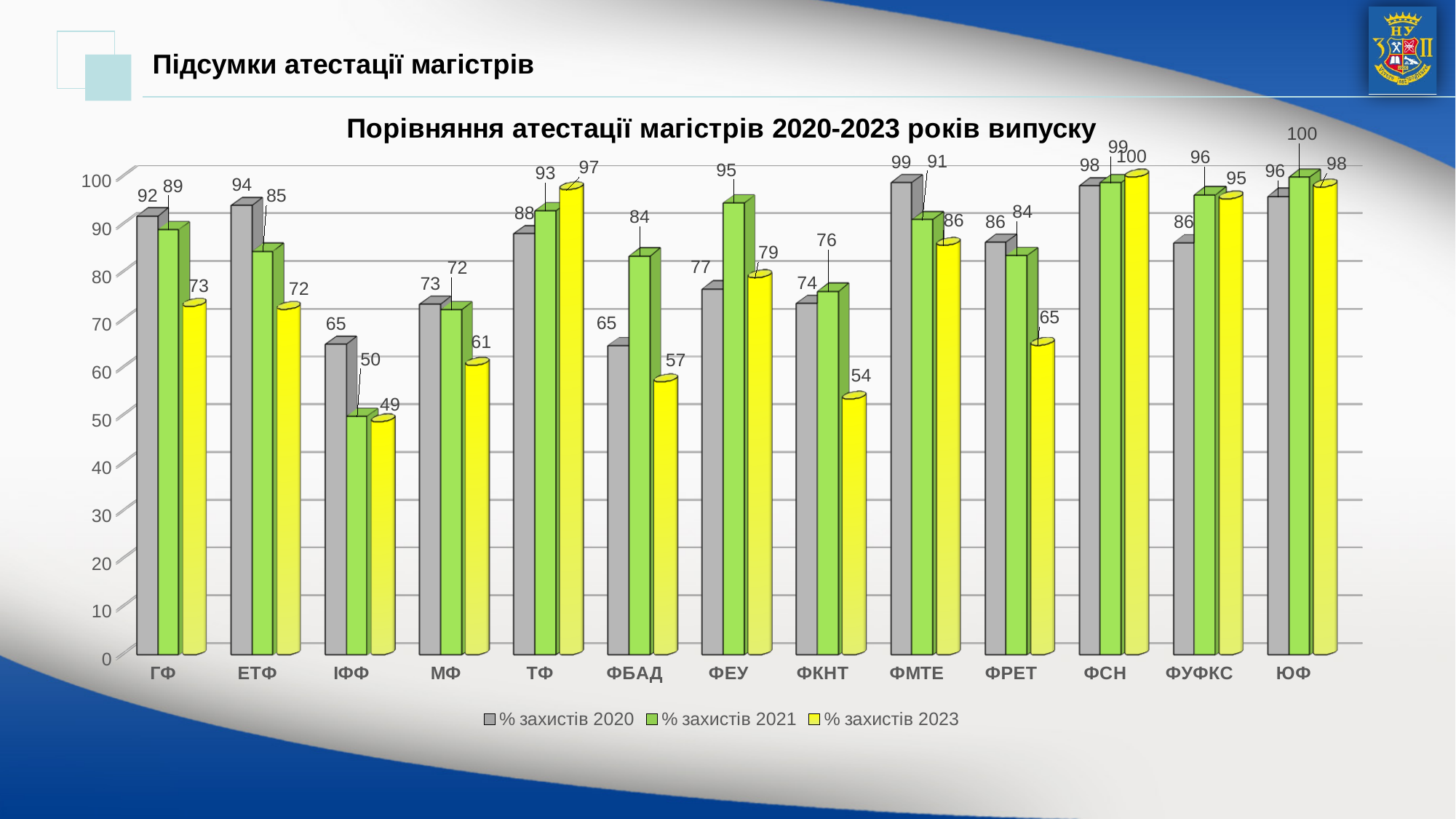
Which category has the highest value for % захистів 2020? ФМТЕ What is the value of % захистів 2021 for ФБАД? 84 What is the title of the chart? Порівняння атестації магістрів 2020-2023 років випуску Which category has the lowest value for % захистів 2021? ІФФ How many series does the legend list? 3 Which category has the highest value for % захистів 2023? ФСН What is the value of % захистів 2020 for ФМТЕ? 99 Which is larger for ФЕУ: % захистів 2020 or % захистів 2021? % захистів 2021 What is the difference between % захистів 2021 and % захистів 2023 for ФКНТ? 22 How many categories are shown on the x axis? 13 What is the value of % захистів 2023 for ТФ? 97 What kind of chart is shown on the slide? bar chart